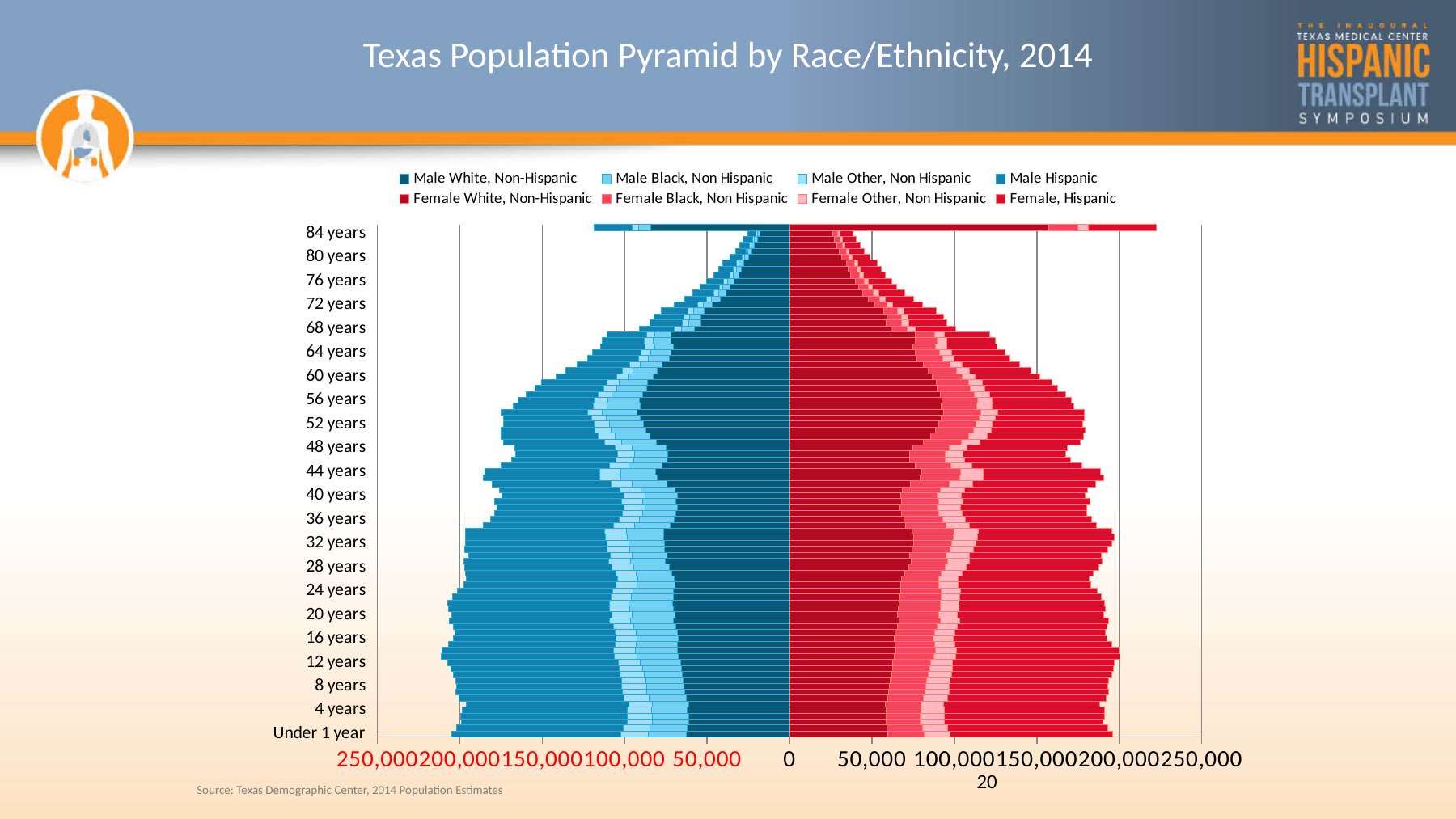
Is the total male bar for 80 years greater or less than 50,000? less Which is longer, the total male bar for 84 years or the total female bar for 84 years? Female 84 years How many age labels are shown on the vertical axis? 22 Which legend series is shown in the darkest blue, nearest the centre on the male side? Male White, Non-Hispanic How many series does the legend list? 8 What kind of chart is shown on the slide? Bar chart (stacked horizontal bars, population pyramid) Is the total male bar for 72 years greater or less than 100,000? less Is the total male bar for 84 years greater or less than 150,000? less What is the title of the chart? Texas Population Pyramid by Race/Ethnicity, 2014